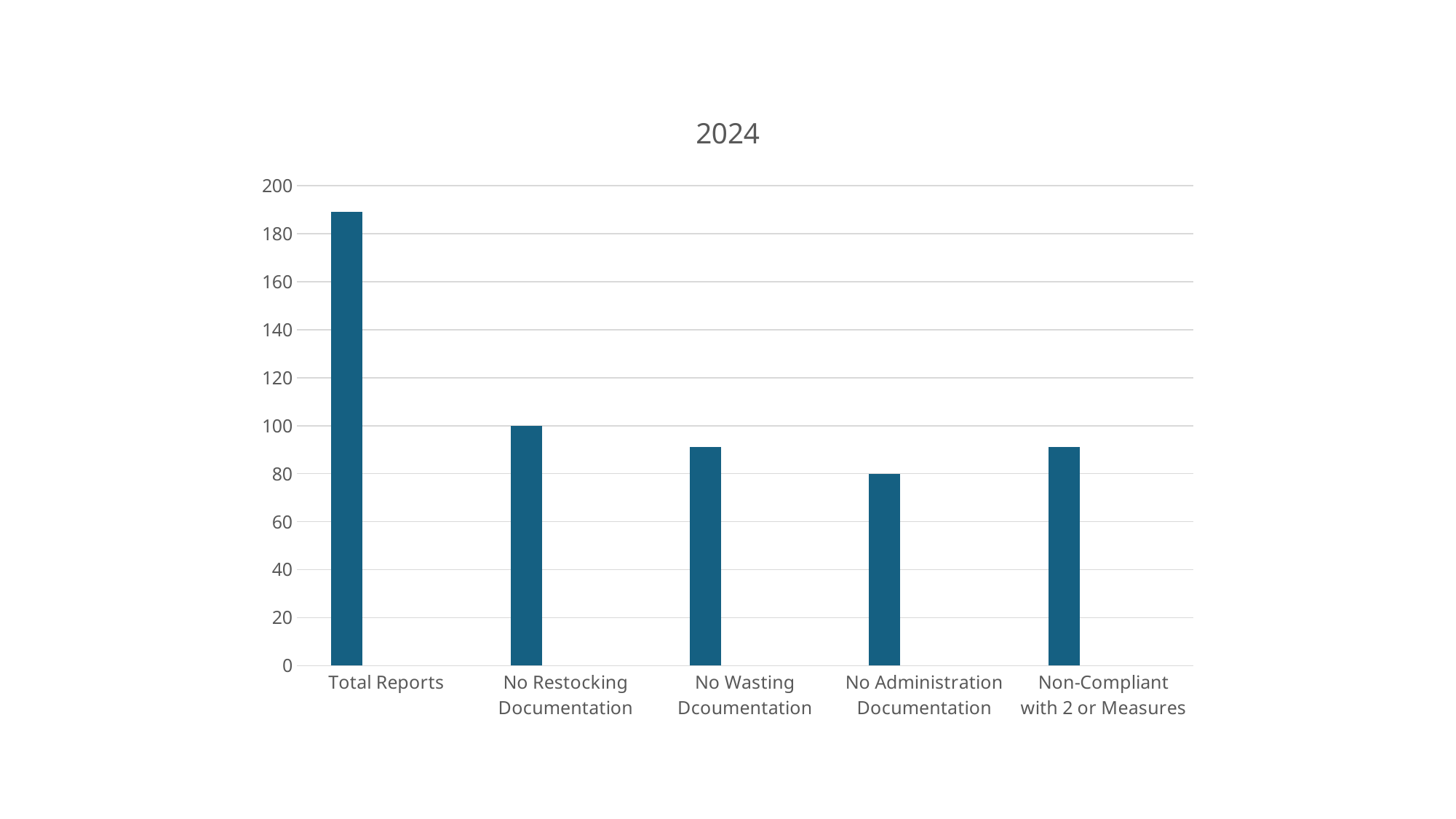
Is the value for No Wasting Dcoumentation greater or less than 100? less How many categories are shown on the x axis of the chart? 5 What is the value for No Restocking Documentation? 100 What is the difference between the value for No Restocking Documentation and the value for No Administration Documentation? 20 Which category has the highest value in the chart? Total Reports What is the title of the chart? 2024 Is the value for Total Reports greater or less than 180? greater What kind of chart is shown on the slide? bar chart Is the value for Non-Compliant with 2 or Measures greater or less than 80? greater Which is larger, the value for Total Reports or the value for No Restocking Documentation? Total Reports What is the value for No Administration Documentation? 80 Which category has the lowest value in the chart? No Administration Documentation